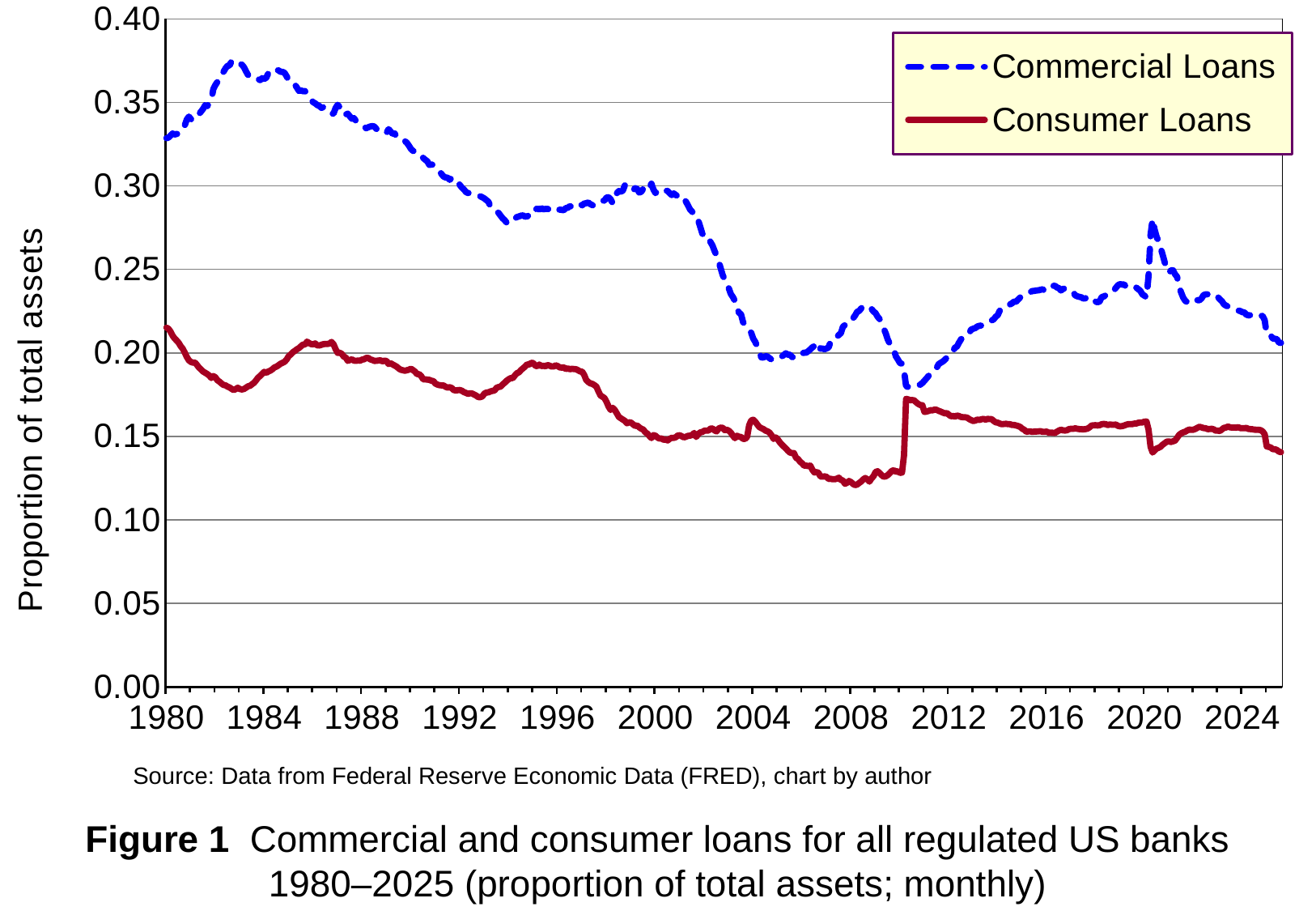
How many series does the legend list? 2 Is the value for Commercial Loans in 1984 greater or less than 0.35? greater Does the Consumer Loans line rise or fall from 1980 to 2008? Fall Is the value for Consumer Loans in 1996 greater or less than 0.20? less Is the value for Consumer Loans in 2008 greater or less than 0.15? less What is the label on the vertical axis? Proportion of total assets In 2000, which series has the higher value, Commercial Loans or Consumer Loans? Commercial Loans Which series is drawn with a dashed blue line? Commercial Loans What kind of chart is shown on the slide? Line chart Overall, does the Commercial Loans line rise or fall from 1980 to 2024? Fall